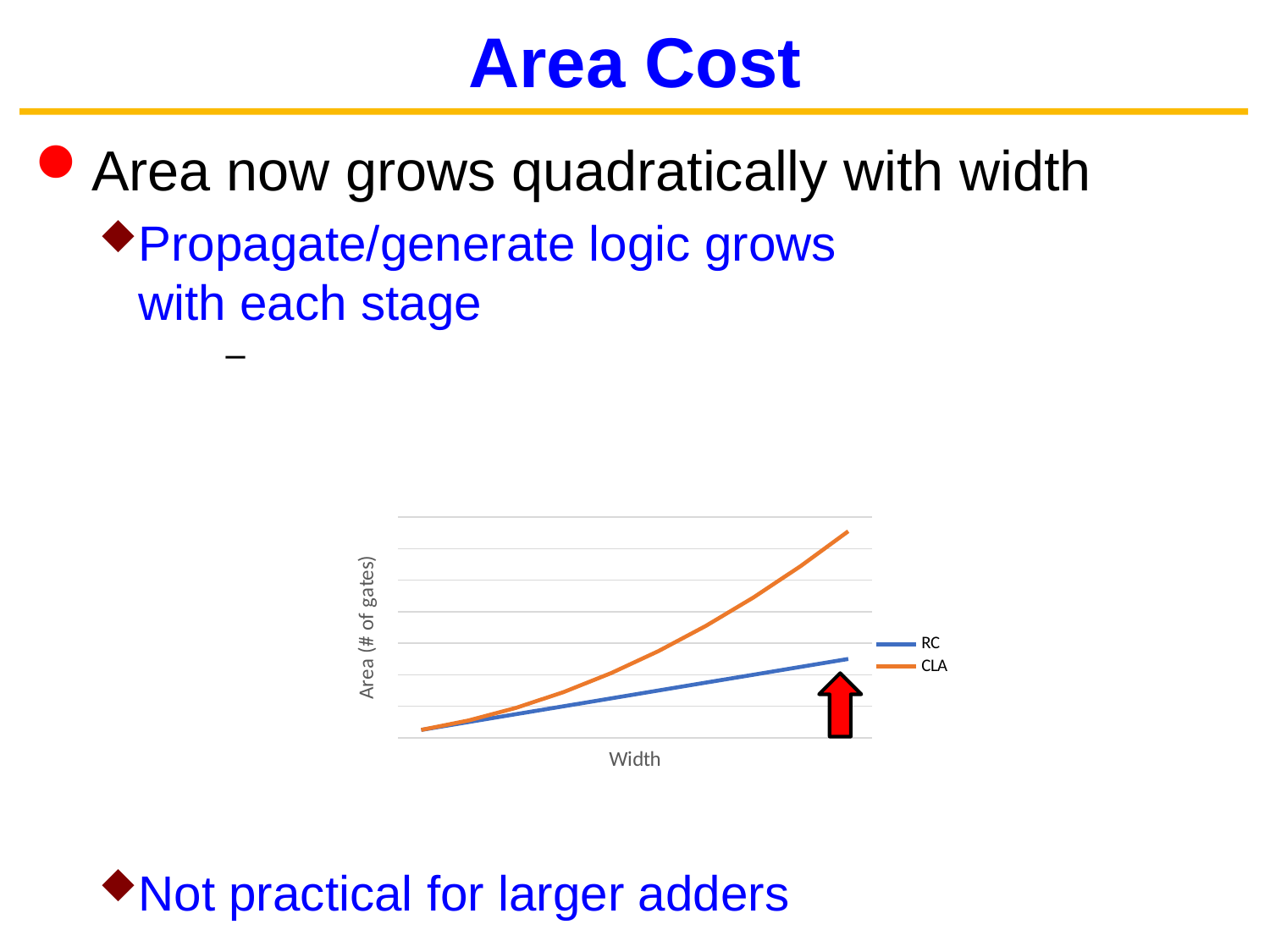
Which series has the lower area at the right end of the chart? RC Does the area for CLA rise or fall as width increases? rise How many series does the chart's legend list? 2 What is the label of the vertical axis of the chart? Area (# of gates) Which series reaches the higher area at the largest width shown? CLA Which series grows faster with width, RC or CLA? CLA What kind of chart is shown on the slide? line chart Does the area for RC rise or fall as width increases? rise What is the label of the horizontal axis of the chart? Width